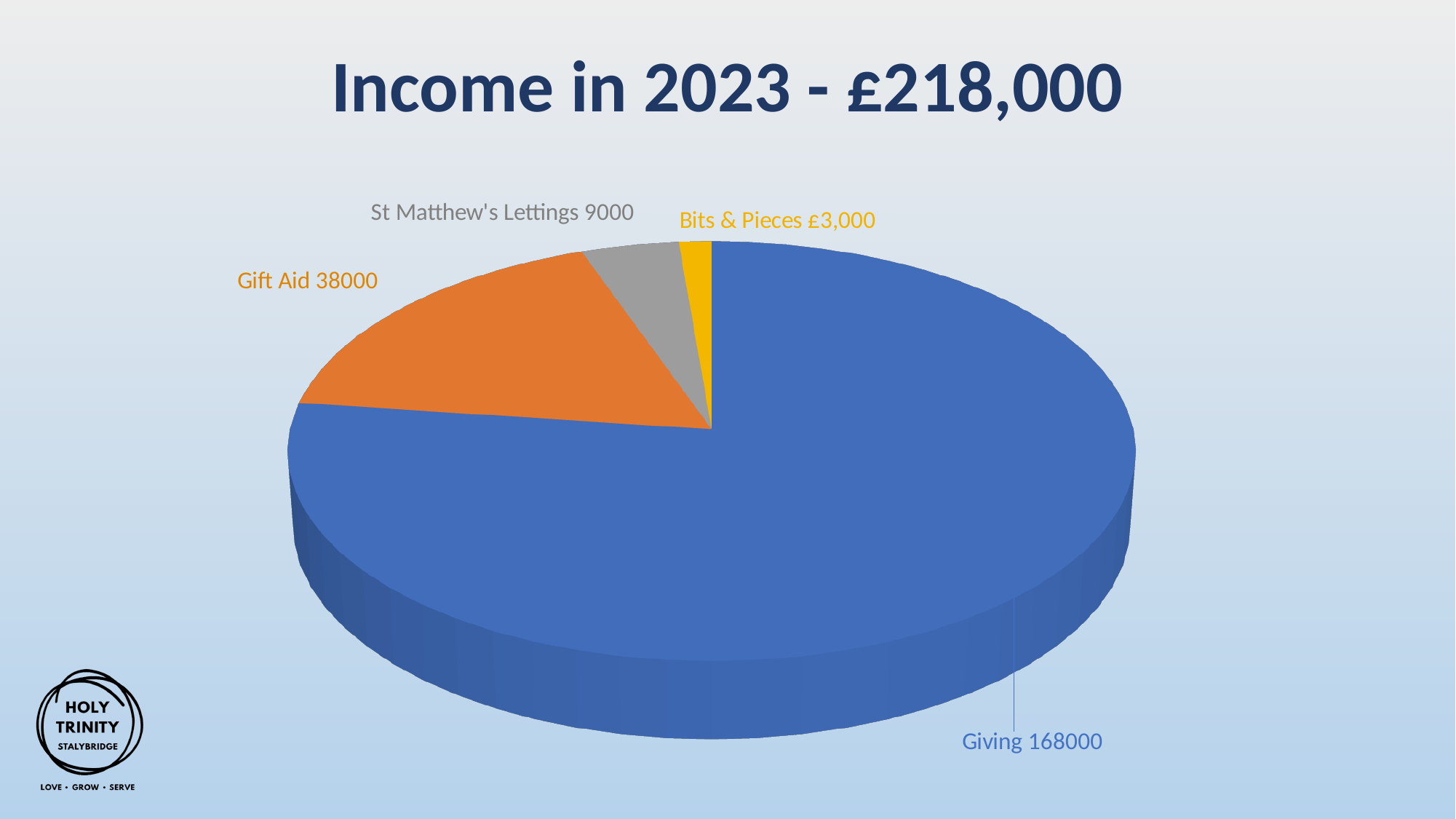
What is the value shown for Giving? 168000 What is the difference between the Giving value and the Gift Aid value? 130000 What is the title of the chart? Income in 2023 - £218,000 Which category has the largest slice of the pie? Giving Which category has the smallest slice of the pie? Bits & Pieces How many slices does the pie chart have? 4 Which is larger, Gift Aid or St Matthew's Lettings? Gift Aid What type of chart is shown on the slide? Pie chart What is the value shown for St Matthew's Lettings? 9000 What is the value shown for Gift Aid? 38000 What is the value shown for Bits & Pieces? £3,000